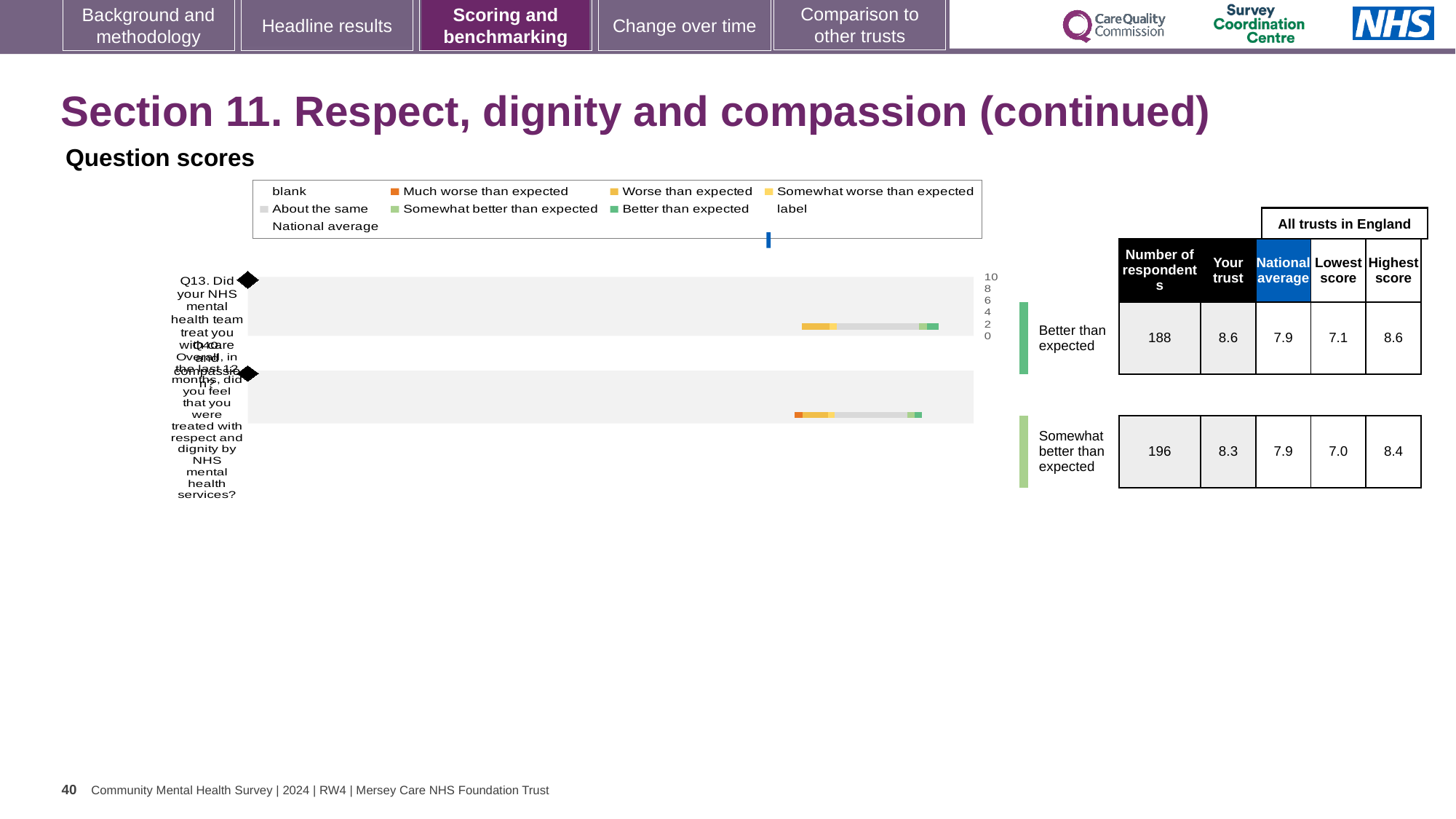
What is the number of respondents for Q14? 196 What benchmark category is shown for Q14 in the question scores chart? Somewhat better than expected What is the 'Your trust' score for Q13 (treated with care and compassion)? 8.6 What is the 'Your trust' score for Q14 (treated with respect and dignity)? 8.3 What is the lowest score across all trusts in England for Q13? 7.1 What is the highest score across all trusts in England for Q14? 8.4 Which question has the higher 'Your trust' score, Q13 or Q14? Q13 What is the national average score for Q14? 7.9 What is the number of respondents for Q13? 188 What is the difference between the 'Your trust' score and the national average for Q13? 0.7 What kind of chart is used to show the question scores on this slide? bar chart How many questions (categories) are plotted in the question scores chart? 2